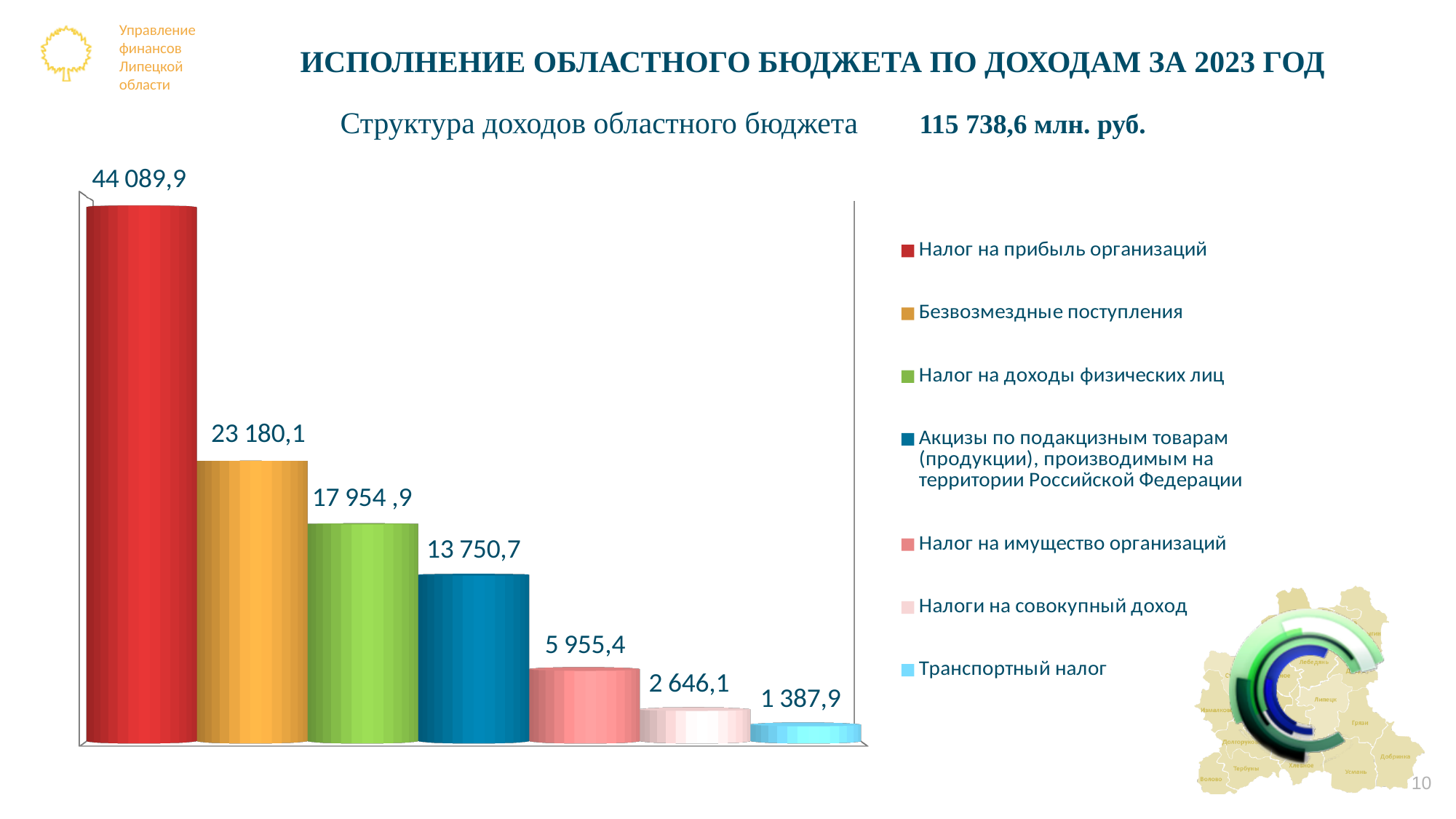
Which is larger: Налог на доходы физических лиц or Акцизы по подакцизным товарам? Налог на доходы физических лиц Which category has the highest value? Налог на прибыль организаций What is the difference between Налог на прибыль организаций and Безвозмездные поступления? 20 909,8 How many categories are shown in the chart? 7 What is the value for Налог на прибыль организаций? 44 089,9 What is the value for Акцизы по подакцизным товарам (продукции), производимым на территории Российской Федерации? 13 750,7 What is the value for Транспортный налог? 1 387,9 Which category has the lowest value? Транспортный налог What kind of chart is shown on the slide? Bar chart What is the value for Безвозмездные поступления? 23 180,1 What is the difference between Налог на имущество организаций and Налоги на совокупный доход? 3 309,3 What is the value for Налог на имущество организаций? 5 955,4